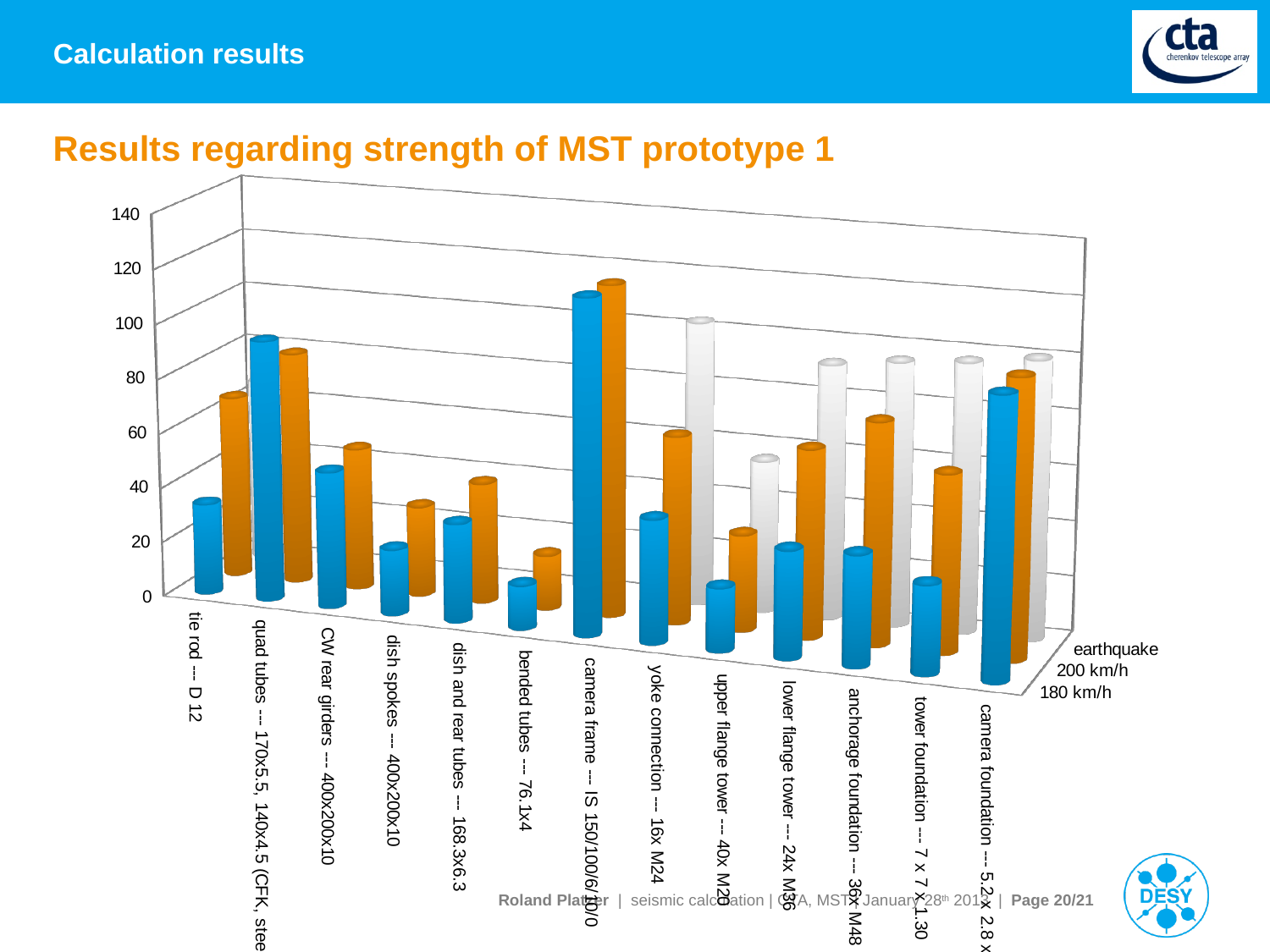
Is the 180 km/h value for camera frame greater or less than 100? greater Which category has the highest value for the 200 km/h series? camera frame --- IS 150/100/6/10/0 How many categories have an earthquake bar? 6 What is the title of the chart section on the slide? Results regarding strength of MST prototype 1 How many categories are shown along the x axis? 13 What kind of chart is shown on the slide? bar chart For the 200 km/h series, which is larger: quad tubes or dish spokes? quad tubes Which category has the lowest value for the 180 km/h series? bended tubes --- 76.1x4 For the 180 km/h series, which is larger: camera frame or tie rod? camera frame Which category has the highest value for the 180 km/h series? camera frame --- IS 150/100/6/10/0 Is the 180 km/h value for bended tubes greater or less than 40? less How many series does the legend list? 3